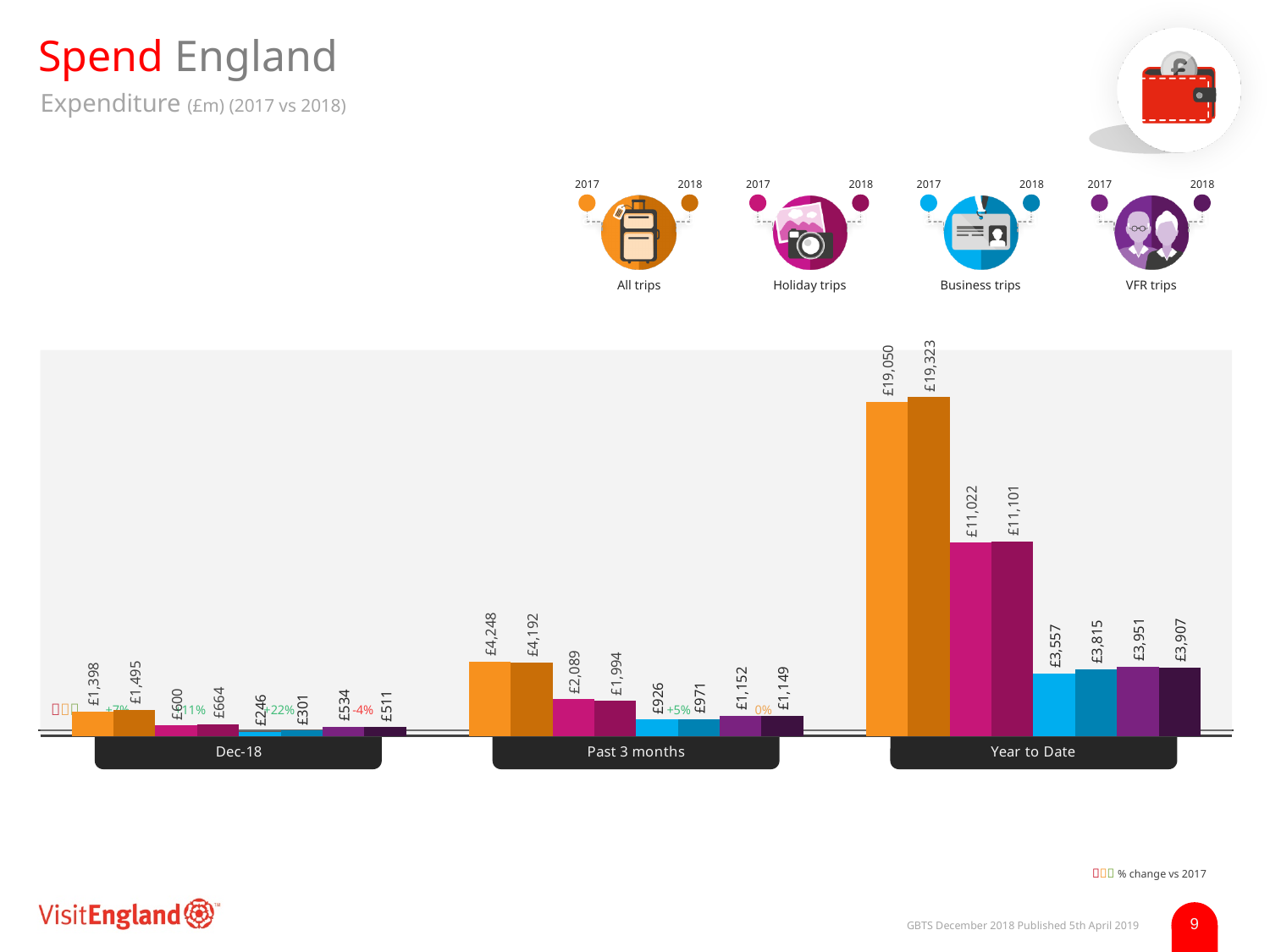
Which period group has the highest All trips expenditure? Year to Date What is the Holiday trips expenditure for 2017 in the Past 3 months group? £2,089 What is the difference between the Holiday trips expenditure for 2017 and 2018 in the Past 3 months group? £95 What is the All trips expenditure for 2018 in the Year to Date group? £19,323 What is the VFR trips expenditure for 2017 in the Year to Date group? £3,951 In the Year to Date group, which is larger: Business trips 2018 or VFR trips 2018? VFR trips 2018 Which trip type has the lowest expenditure in the Dec-18 group for 2017? Business trips What kind of chart is shown on the slide? Bar chart How many period groups are shown on the x axis? 3 What is the percentage change vs 2017 shown for VFR trips in the Dec-18 group? -4% What is the difference between the All trips expenditure for 2018 and 2017 in the Year to Date group? £273 What is the Business trips expenditure for 2018 in the Dec-18 group? £301